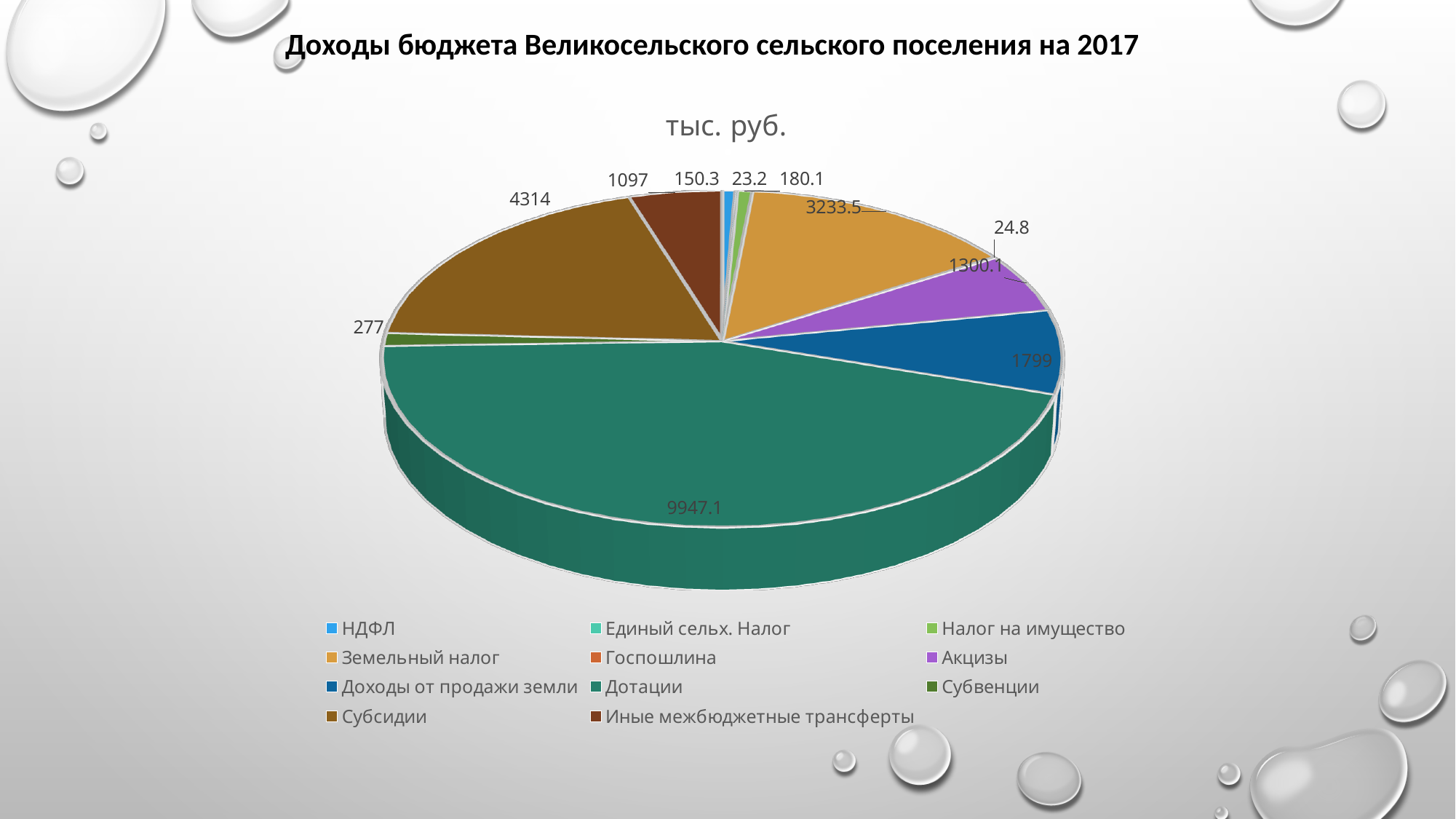
What is the difference between Субсидии and Иные межбюджетные трансферты? 3217 What kind of chart is shown on the slide? Pie chart How many categories does the legend list? 11 What is the value for Иные межбюджетные трансферты? 1097 What is the value for Дотации? 9947.1 What is the value for Земельный налог? 3233.5 Which is larger, Земельный налог or Доходы от продажи земли? Земельный налог What is the title shown above the chart? тыс. руб. What is the value for Акцизы? 1300.1 What is the value for Субсидии? 4314 Which category has the smallest value? Единый сельх. Налог Which category has the largest value? Дотации